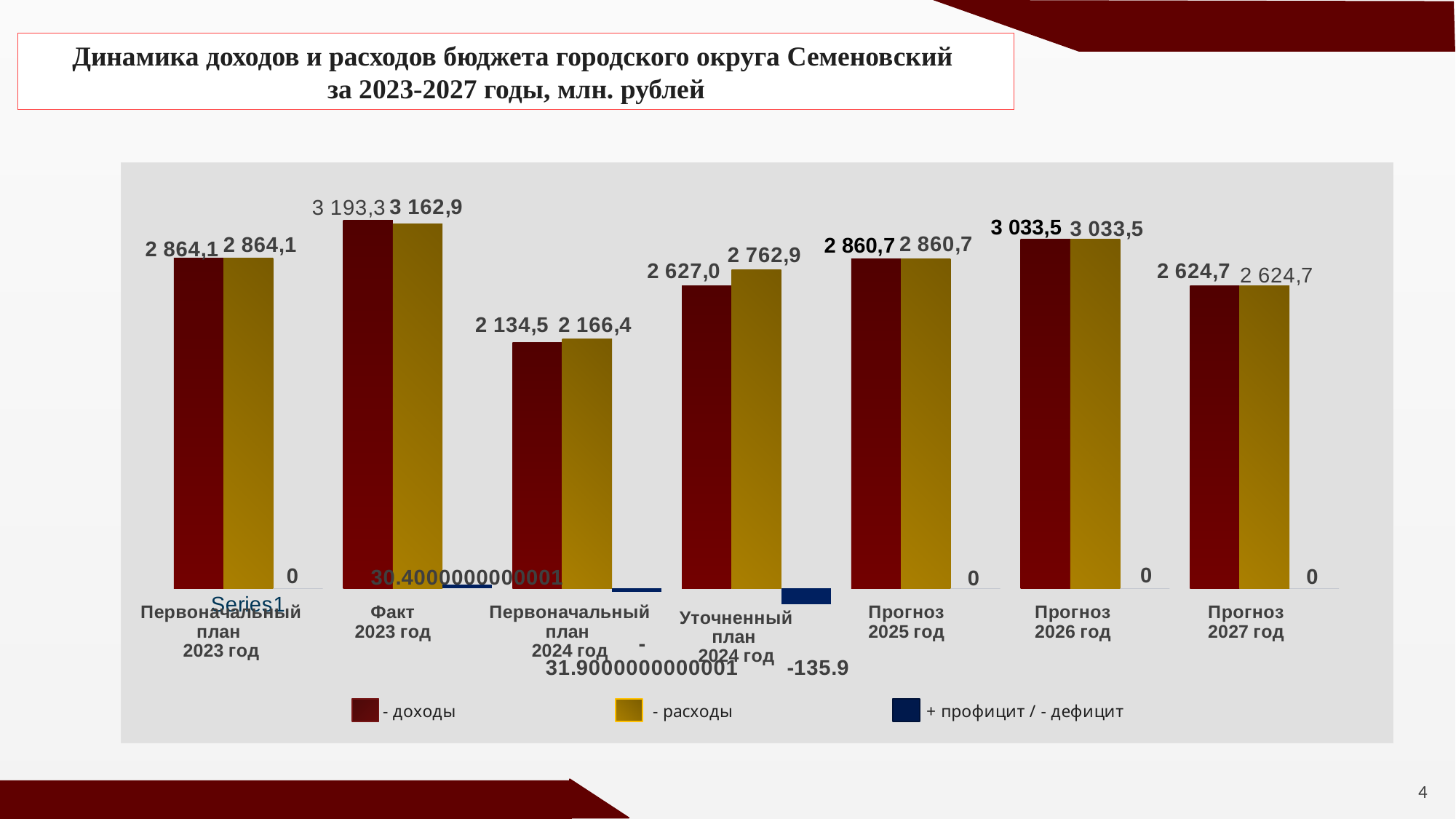
Which category has the highest value of доходы? Факт 2023 год How many series does the legend list? 3 What is the value of расходы for Уточненный план 2024 год? 2 762,9 For Уточненный план 2024 год, which is larger: доходы or расходы? расходы How many categories are shown on the x axis? 7 What is the value of доходы for Факт 2023 год? 3 193,3 What is the difference between доходы and расходы for Факт 2023 год? 30,4 What is the value of расходы for Прогноз 2026 год? 3 033,5 Which category has the lowest value of расходы? Первоначальный план 2024 год What is the value of доходы for Первоначальный план 2024 год? 2 134,5 What kind of chart is shown on the slide? bar chart What is the value of профицит/дефицит for Уточненный план 2024 год? -135.9